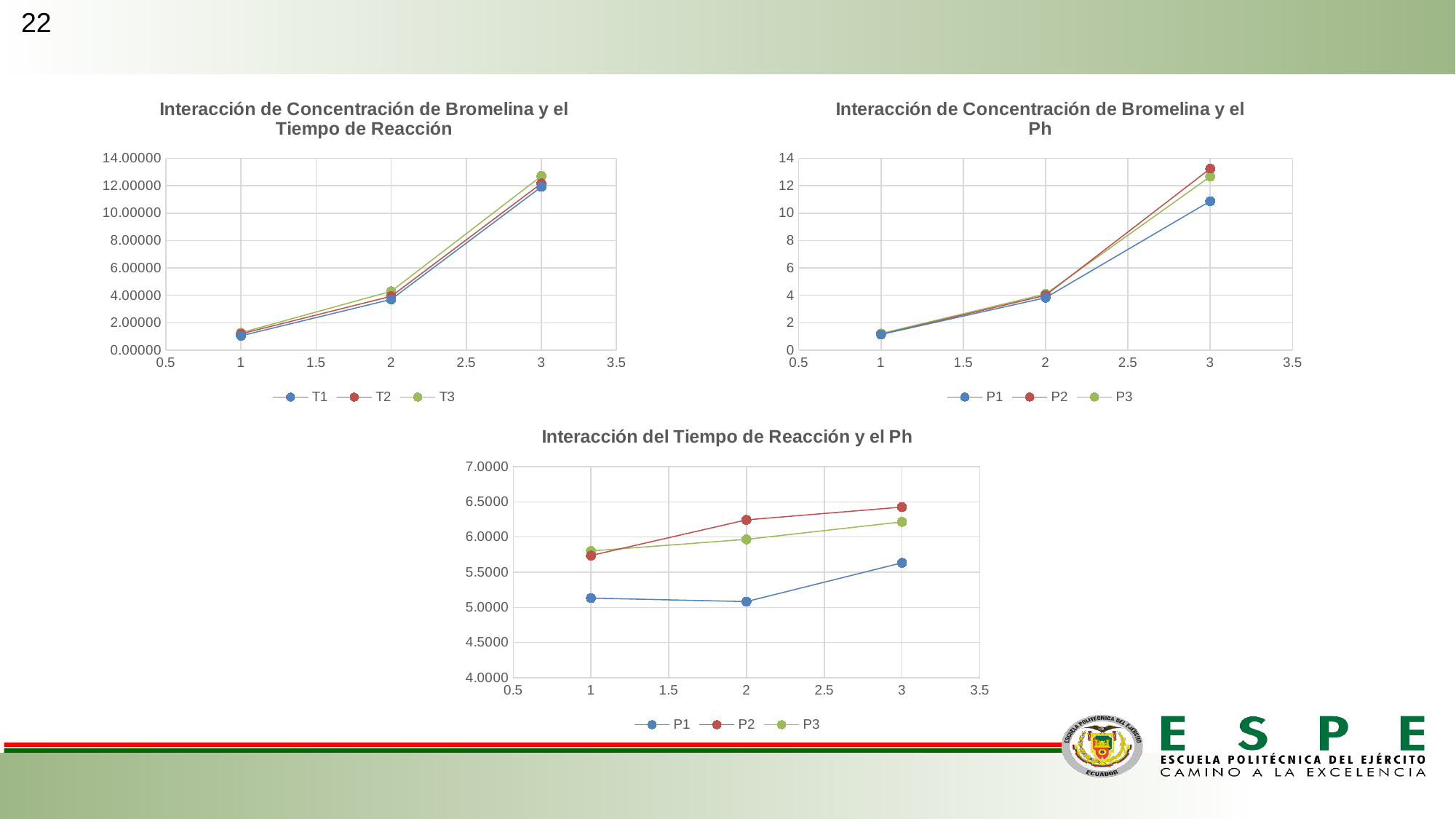
In the chart 'Interacción del Tiempo de Reacción y el Ph', which series has the lowest value at x = 3? P1 In the chart 'Interacción de Concentración de Bromelina y el Ph', which series has the lowest value at x = 3? P1 In the chart 'Interacción de Concentración de Bromelina y el Ph', at x = 3, which is larger: P2 or P1? P2 In the chart 'Interacción de Concentración de Bromelina y el Ph', is the value of P1 at x = 3 greater or less than 12? less In the chart 'Interacción de Concentración de Bromelina y el Tiempo de Reacción', how many series does the legend list? 3 In the chart 'Interacción de Concentración de Bromelina y el Tiempo de Reacción', how many data points does each series have? 3 In the chart 'Interacción de Concentración de Bromelina y el Tiempo de Reacción', do the values of T1 rise or fall as x goes from 1 to 3? Rise In the chart 'Interacción del Tiempo de Reacción y el Ph', at x = 2, which is larger: P2 or P3? P2 In the chart 'Interacción de Concentración de Bromelina y el Tiempo de Reacción', is the value of T3 at x = 3 greater or less than 10.00000? greater In the chart 'Interacción de Concentración de Bromelina y el Ph', what are the names of the series in the legend? P1, P2, P3 What kind of chart is the chart titled 'Interacción de Concentración de Bromelina y el Tiempo de Reacción'? Line chart In the chart 'Interacción del Tiempo de Reacción y el Ph', is the value of P1 at x = 2 greater or less than 5.5000? less